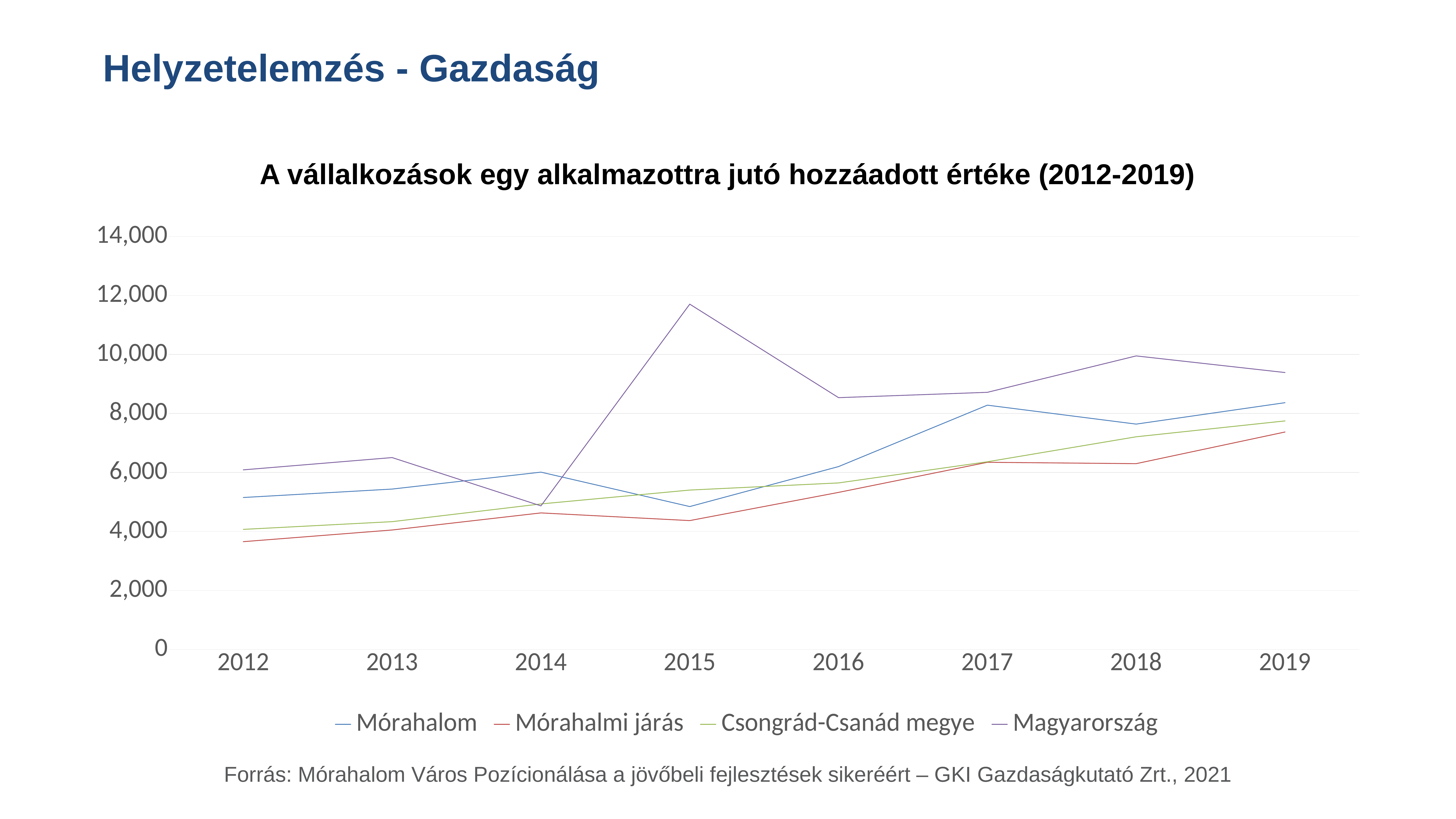
Which series has the lowest value in 2012? Mórahalmi járás Is the value for Mórahalom in 2017 greater or less than 8,000? greater How many years are shown on the x axis? 8 In which year does the Magyarország line reach its highest value? 2015 In 2015, which is higher: Mórahalom or Csongrád-Csanád megye? Csongrád-Csanád megye What is the title of the chart? A vállalkozások egy alkalmazottra jutó hozzáadott értéke (2012-2019) What kind of chart is shown on the slide? line chart Is the value for Magyarország in 2015 greater or less than 10,000? greater Does the Csongrád-Csanád megye line rise or fall from 2012 to 2019? rises Is the value for Mórahalmi járás in 2012 greater or less than 4,000? less In 2019, which is higher: Mórahalom or Mórahalmi járás? Mórahalom How many series does the legend list? 4